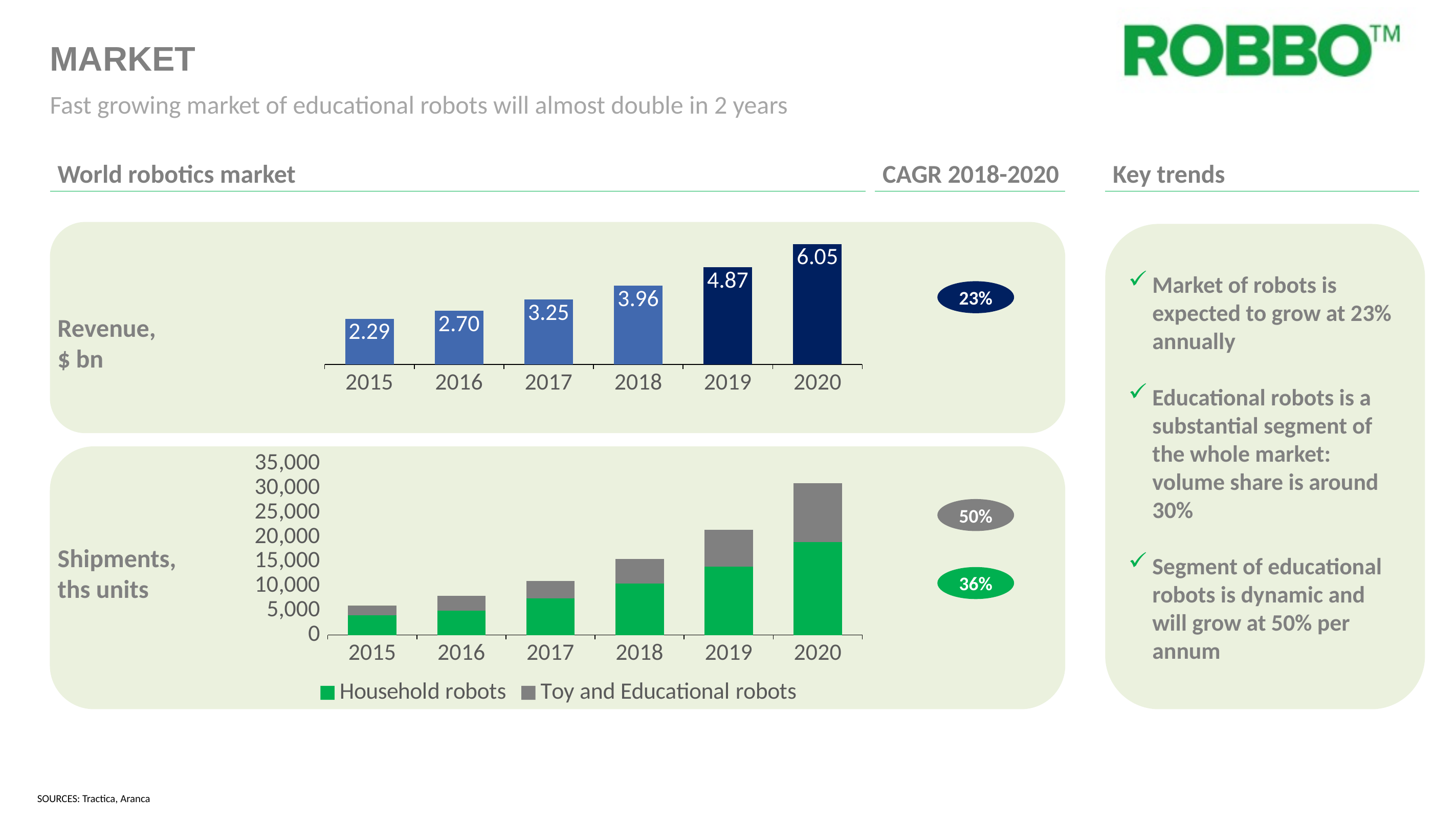
In the Revenue, $ bn chart, which year has the highest revenue? 2020 In the Revenue, $ bn chart, what is the difference between the 2020 and 2018 values? 2.09 How many series does the legend of the Shipments, ths units chart list? 2 In the Revenue, $ bn chart, how many years are shown on the x axis? 6 In the Revenue, $ bn chart, do the values rise or fall from 2015 to 2020? rise In the Revenue, $ bn chart, what is the revenue value for 2020? 6.05 In the Shipments, ths units chart, is the total shipments value for 2020 greater or less than 25,000? greater In the Shipments, ths units chart, is the total shipments value for 2015 greater or less than 10,000? less In the Revenue, $ bn chart, what is the revenue value for 2018? 3.96 In the Shipments, ths units chart, which series is shown in green? Household robots In the Revenue, $ bn chart, which year has the lowest revenue? 2015 What kind of chart is the Shipments, ths units chart? stacked bar chart